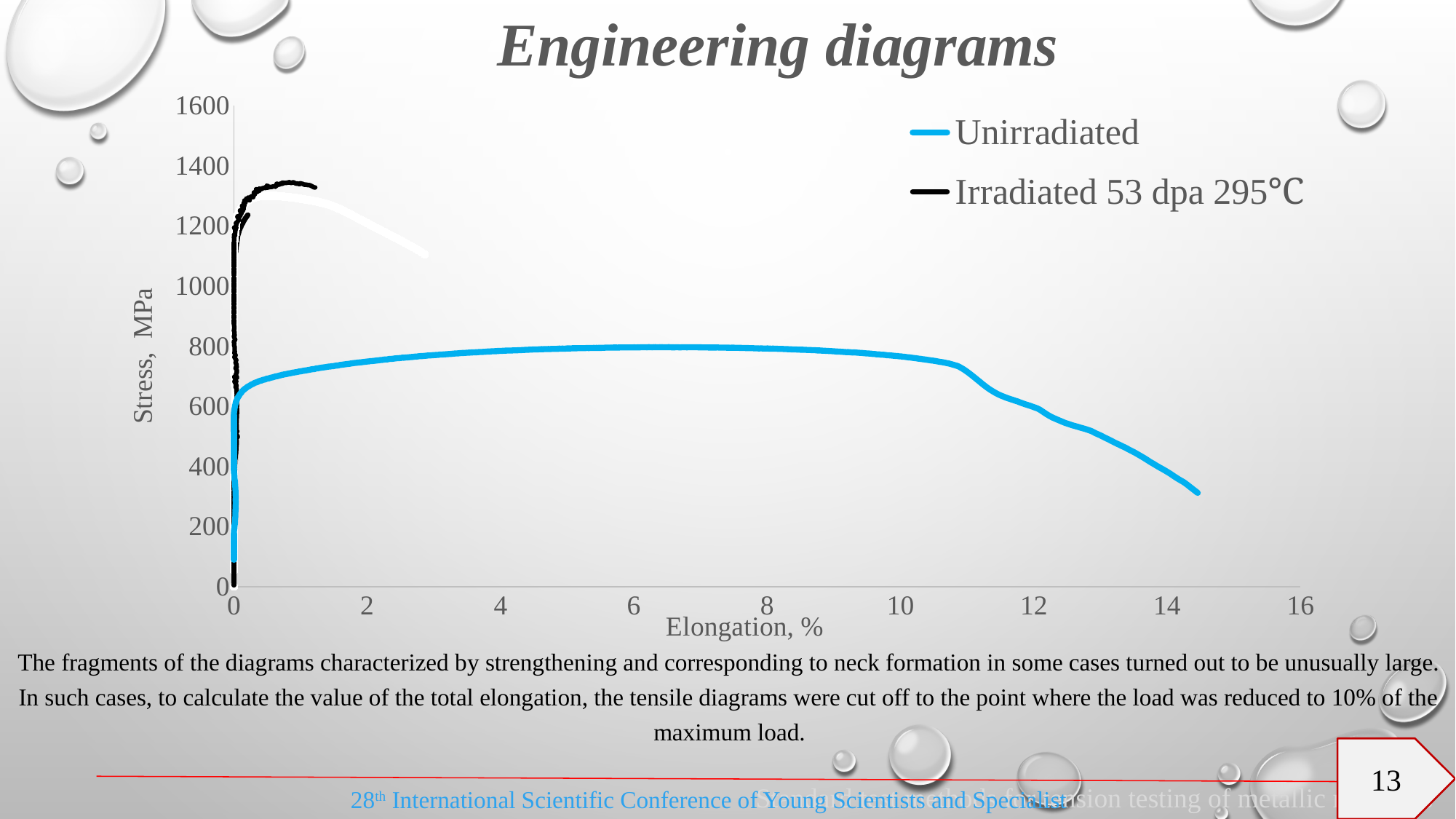
Is the peak stress of the Unirradiated series greater or less than 1000 MPa? less Is the peak stress of the Irradiated 53 dpa 295°C series greater or less than 1200 MPa? greater Is the maximum elongation of the Unirradiated series greater or less than 14%? greater Which series extends to the larger elongation, Unirradiated or Irradiated 53 dpa 295°C? Unirradiated Does the stress of the Unirradiated series rise or fall between 11% and 14% elongation? fall Which series reaches the higher peak stress, Unirradiated or Irradiated 53 dpa 295°C? Irradiated 53 dpa 295°C How many series does the legend list? 2 What is the label of the y axis? Stress, MPa What kind of chart is shown on the slide? Line chart What is the label of the x axis? Elongation, %